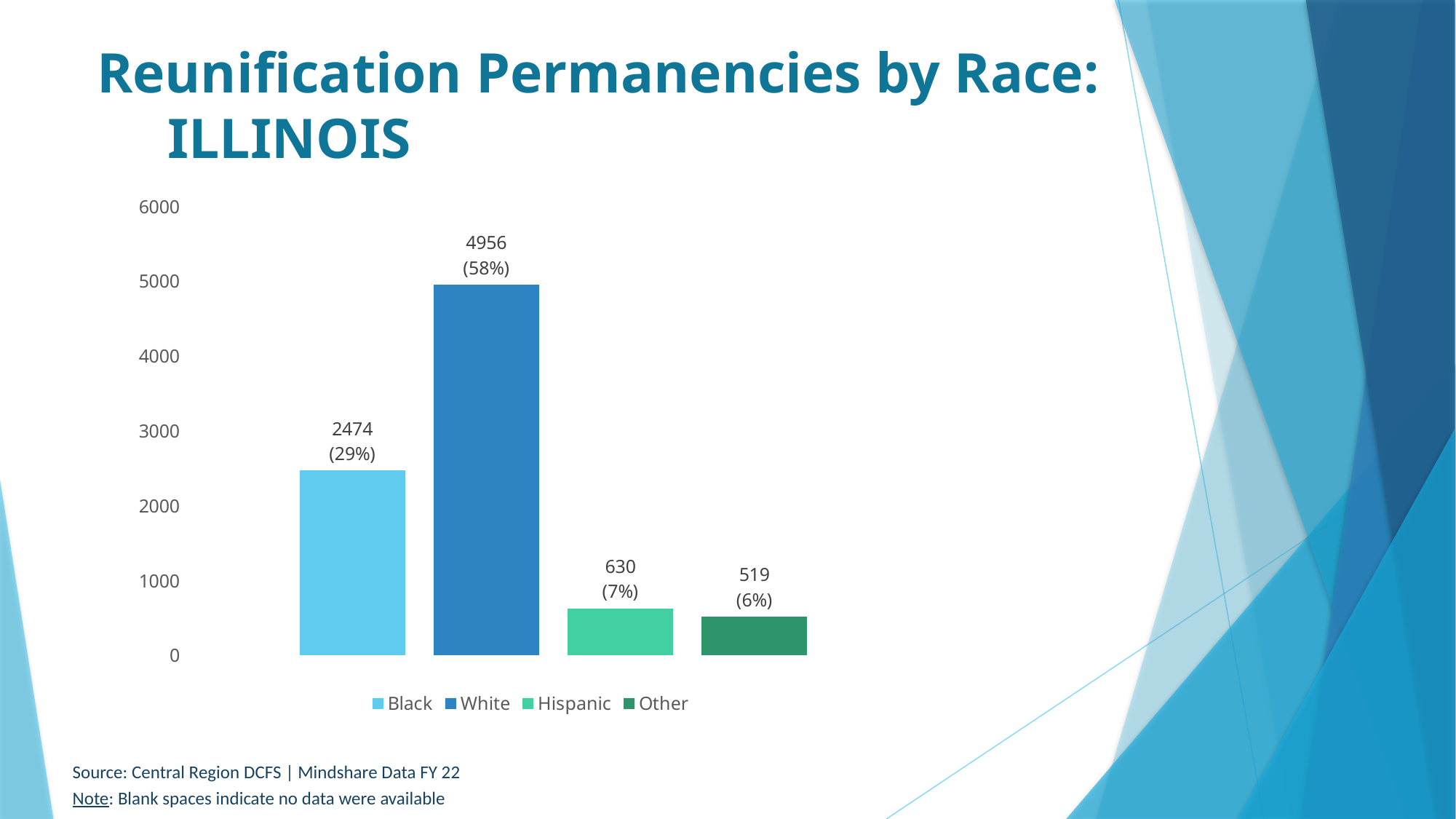
What is the value for White? 4956 Which category has the lowest value? Other Which is larger, the value for Hispanic or the value for Other? Hispanic What is the difference between the values for White and Black? 2482 How many categories are shown in the chart? 4 What kind of chart is shown on the slide? Bar chart Which category has the highest value? White What is the value for Hispanic? 630 Is the value for Black greater or less than 2000? greater What is the title of the slide? Reunification Permanencies by Race: ILLINOIS What is the value for Black? 2474 What percentage is shown for Other? 6%